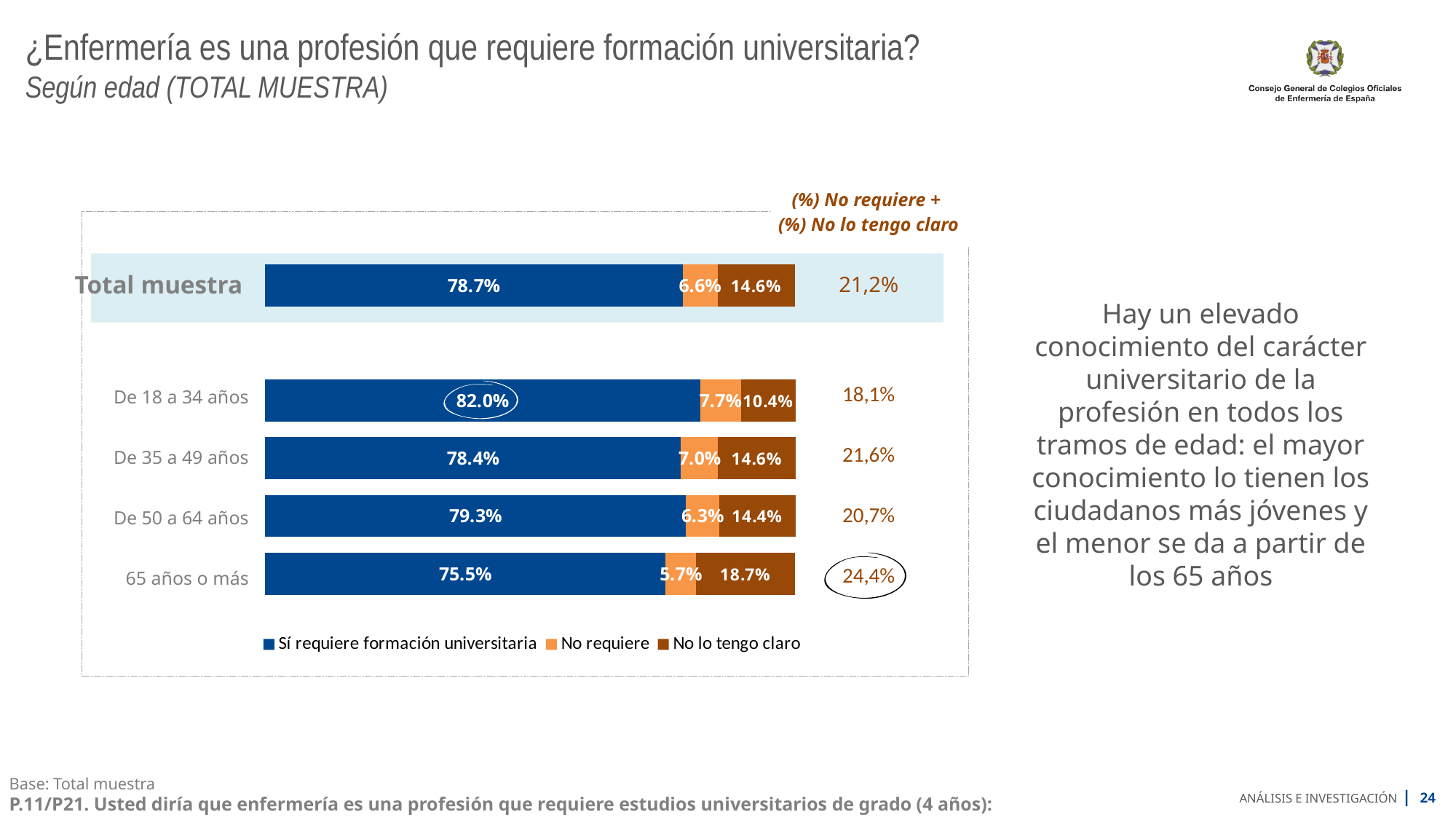
How many bars (categories) are shown in the chart, including 'Total muestra'? 5 Which age group has the lowest 'Sí requiere formación universitaria' value? 65 años o más What percentage of the 'De 18 a 34 años' group answered 'Sí requiere formación universitaria'? 82.0% How many series does the legend list? 3 What is the 'No lo tengo claro' value for the '65 años o más' group? 18.7% What is the combined '(%) No requiere + (%) No lo tengo claro' figure shown for the '65 años o más' group? 24,4% Which age group has the highest 'Sí requiere formación universitaria' value? De 18 a 34 años What is the difference in percentage points between the 'Sí requiere formación universitaria' values for 'De 18 a 34 años' and '65 años o más'? 6.5 percentage points Which has a larger 'No requiere' value: 'De 35 a 49 años' or 'De 50 a 64 años'? De 35 a 49 años What kind of chart is shown on the slide? Stacked horizontal bar chart What colour represents the 'Sí requiere formación universitaria' series? Dark blue What is the 'No requiere' value for 'Total muestra'? 6.6%